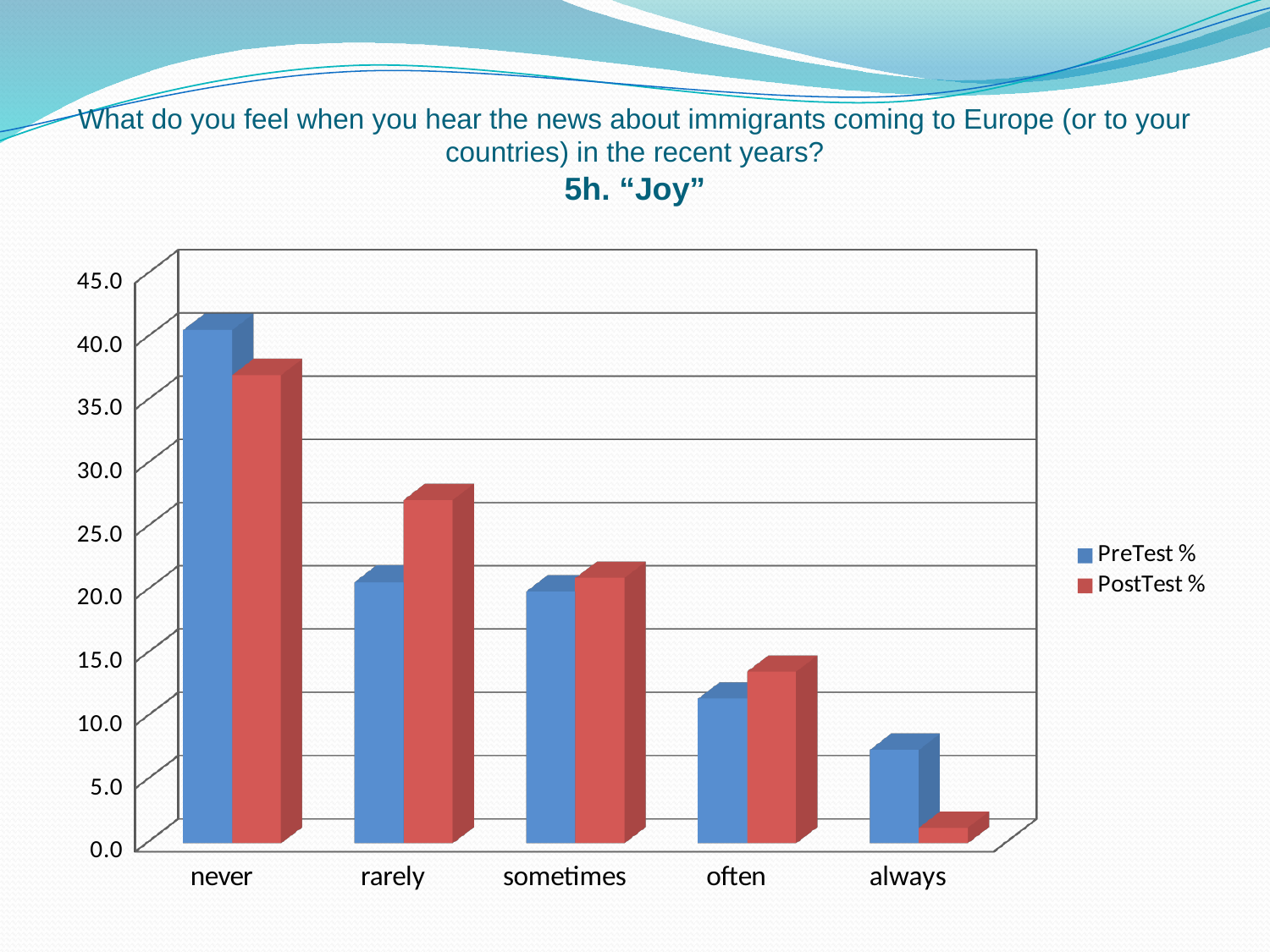
Which category has the highest PreTest % value? never How many series does the legend list? 2 Which category has the lowest PostTest % value? always Which category has the lowest PreTest % value? always Is the PostTest % value for 'rarely' greater or less than 25.0? greater Is the PostTest % value for 'always' greater or less than 5.0? less For the category 'never', which is larger: PreTest % or PostTest %? PreTest % For the category 'always', which is larger: PreTest % or PostTest %? PreTest % Do the PostTest % values rise or fall from 'never' to 'always'? fall What kind of chart is shown on the slide? bar chart For the category 'rarely', which is larger: PreTest % or PostTest %? PostTest % How many categories are shown on the x axis? 5